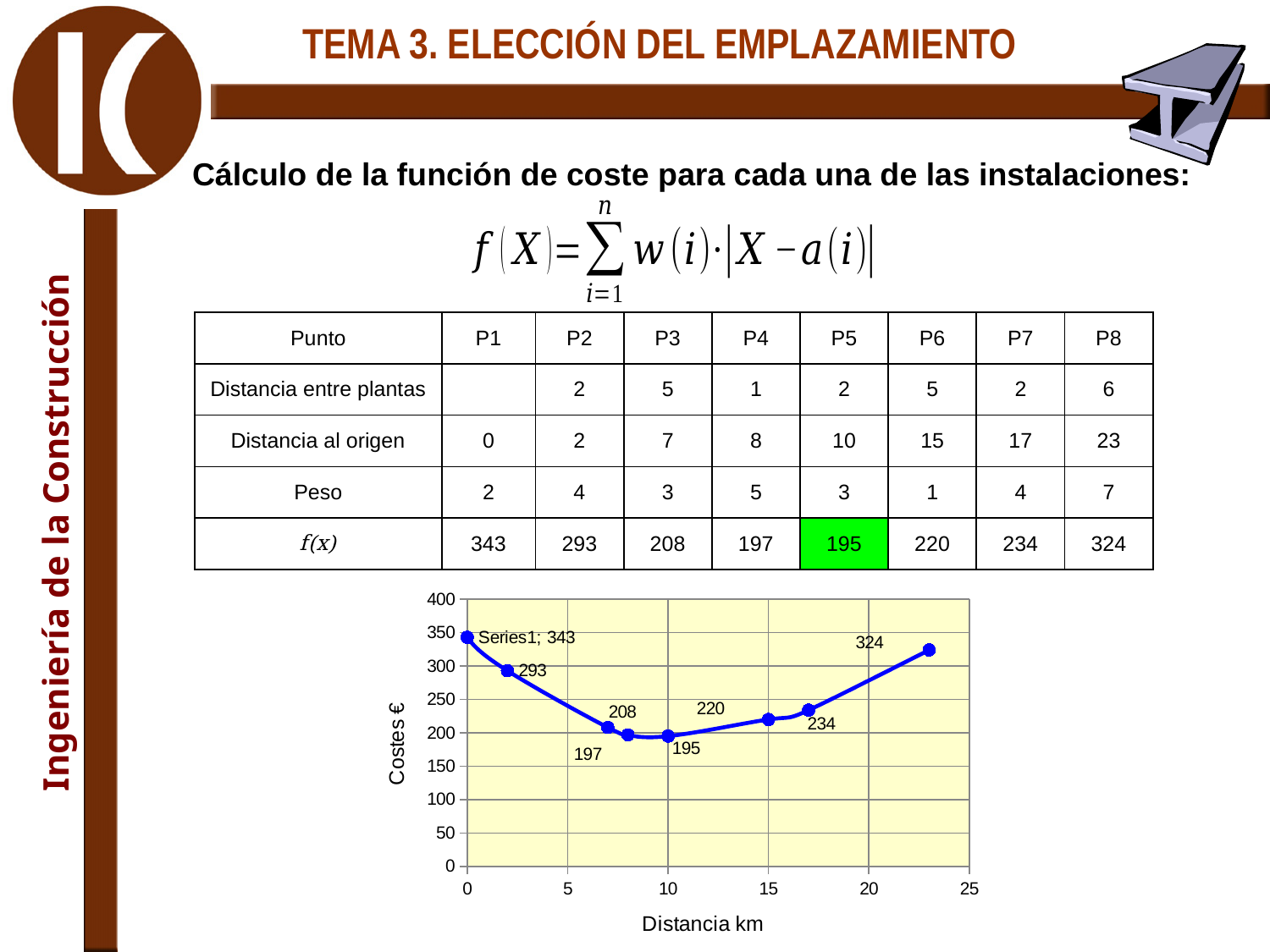
How many data points are plotted on the chart? 8 What kind of chart is shown at the bottom of the slide? line chart What is the difference between the highest cost value (343) and the lowest cost value (195) on the chart? 148 Do the cost values rise or fall as the distance increases from 0 km to 10 km? fall Which is larger on the chart: the value labelled 220 or the value labelled 234? 234 Is the cost value at a distance of 15 km greater or less than 200? greater What is the cost value plotted at a distance of 0 km? 343 What is the title of the x axis of the chart? Distancia km What is the highest cost value shown on the chart? 343 What is the cost value plotted at a distance of 10 km? 195 What is the lowest cost value shown on the chart? 195 What is the cost value plotted at a distance of 23 km? 324